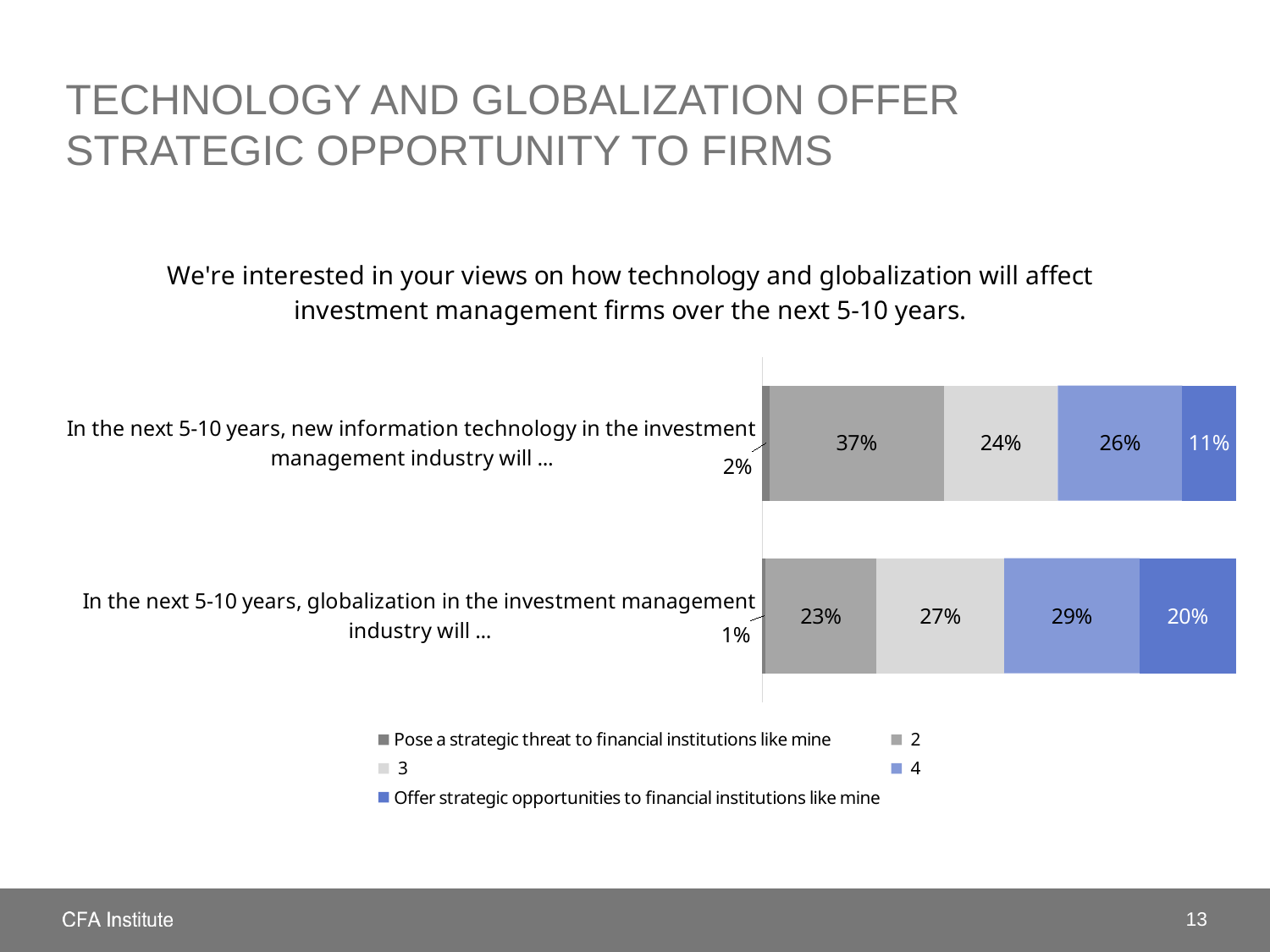
What is the difference between the 'Offer strategic opportunities' values for globalization and new information technology? 9% What is the total of all segments in the bar about globalization? 100% What kind of chart is shown on the slide? Stacked bar chart What percentage said globalization will 'Pose a strategic threat to financial institutions like mine'? 1% Which segment is the largest in the bar about new information technology? 2 (37%) What is the value of the '3' segment for the bar about globalization? 27% What percentage of respondents said globalization will 'Offer strategic opportunities to financial institutions like mine'? 20% How many categories (bars) are plotted in the chart? 2 How many series does the legend list? 5 What is the value of the '2' segment for the bar about new information technology? 37% Which bar has the larger '4' segment, new information technology or globalization? Globalization What percentage of respondents said new information technology will 'Offer strategic opportunities to financial institutions like mine'? 11%